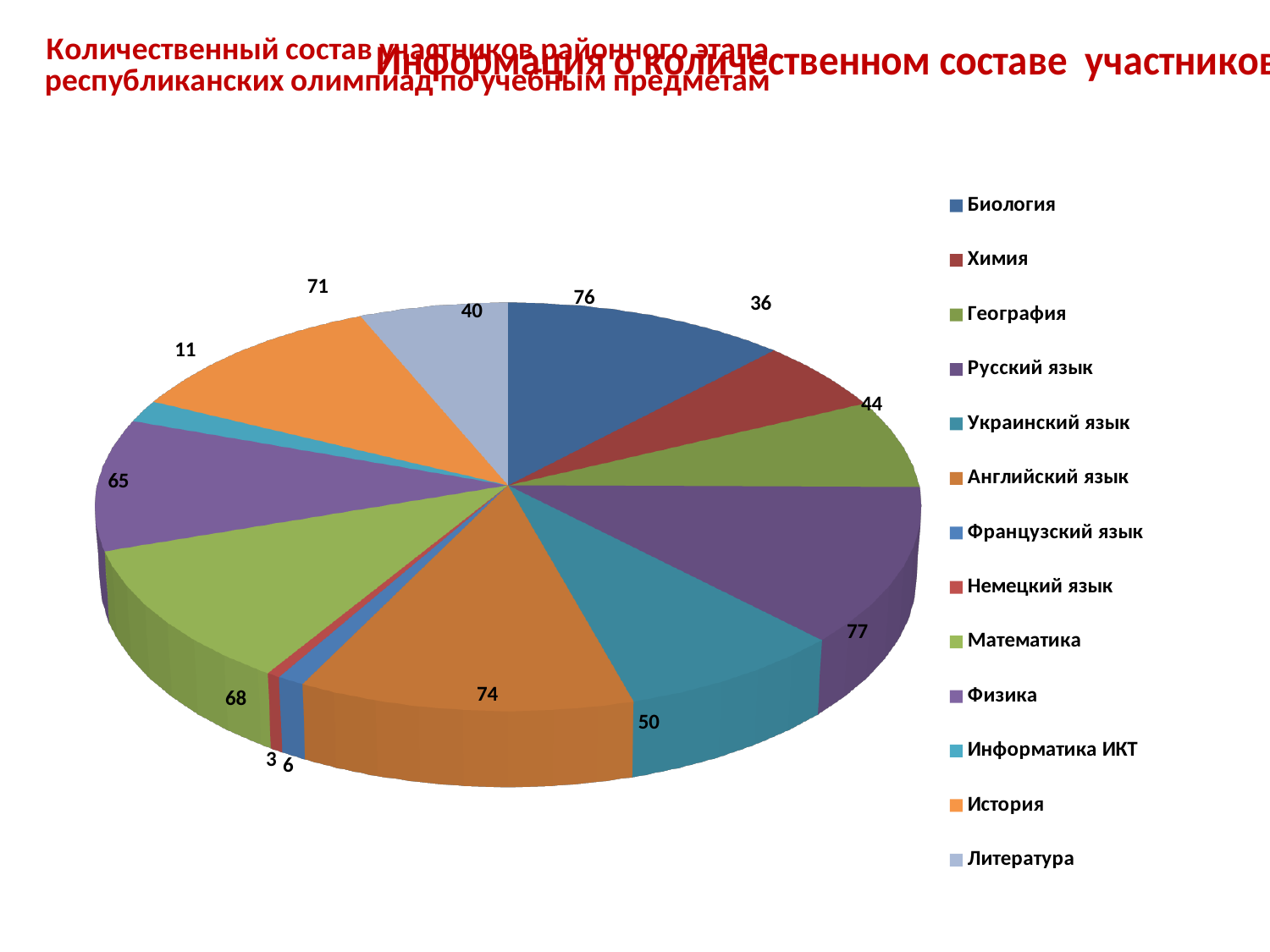
What is the value for Русский язык in the pie chart? 77 Which category has the smallest slice in the pie chart? Немецкий язык What is the value for Английский язык in the pie chart? 74 What is the value for Литература in the pie chart? 40 Which is larger in the pie chart, the value for История or the value for Украинский язык? История How many categories does the legend of the pie chart list? 13 Which category has the largest slice in the pie chart? Русский язык What is the difference between the values for Математика and Физика? 3 What is the value for Немецкий язык in the pie chart? 3 What is the value for Биология in the pie chart? 76 What colour is the slice for Информатика ИКТ in the pie chart? cyan (light blue) What kind of chart is shown on the slide? pie chart